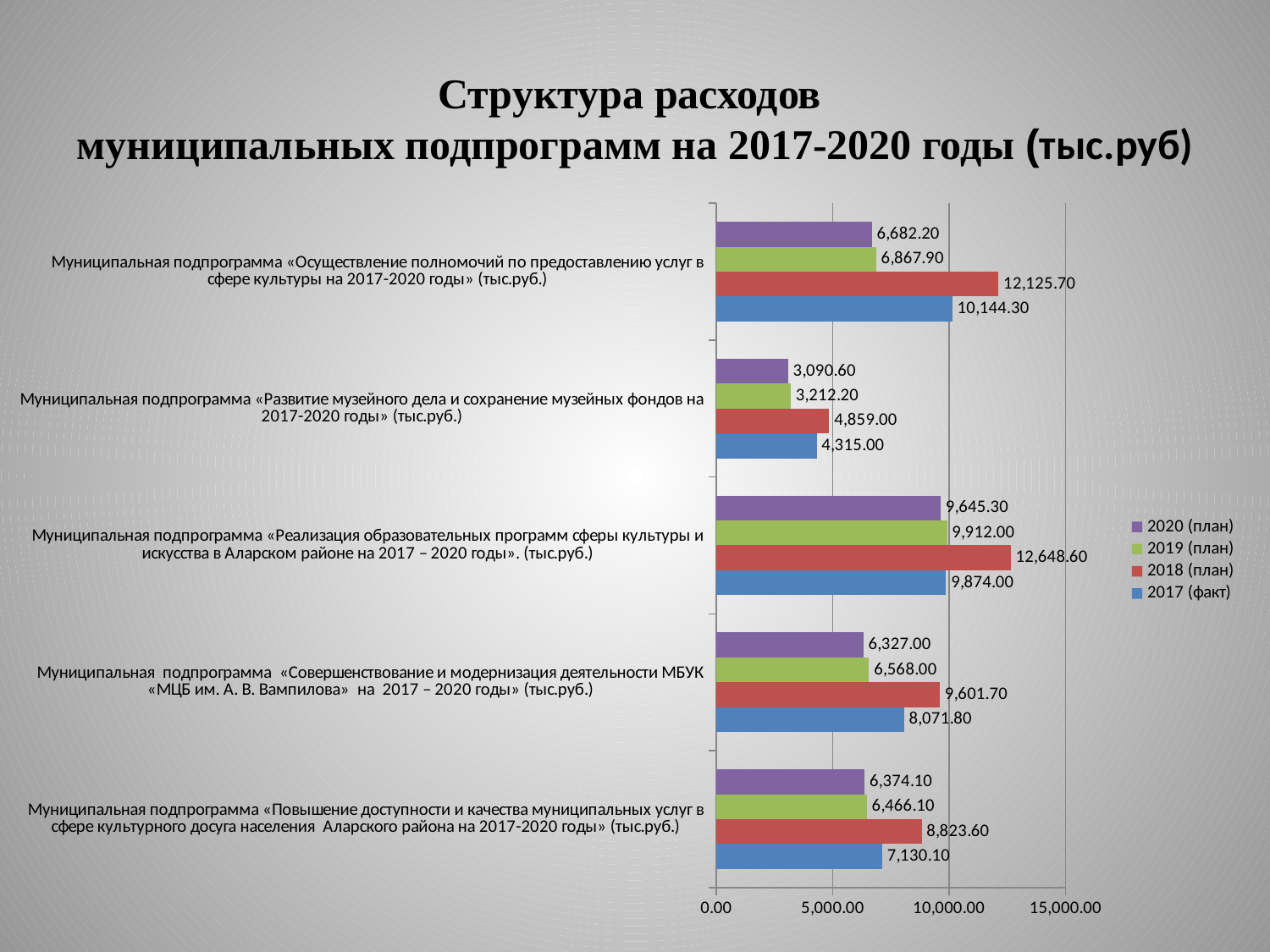
What type of chart is shown on the slide? Bar chart What is the 2020 (план) value for the subprogramme «Повышение доступности и качества муниципальных услуг в сфере культурного досуга населения Аларского района на 2017-2020 годы»? 6,374.10 What is the 2018 (план) value for the subprogramme «Осуществление полномочий по предоставлению услуг в сфере культуры на 2017-2020 годы»? 12,125.70 Which subprogramme has the lowest 2019 (план) value? «Развитие музейного дела и сохранение музейных фондов на 2017-2020 годы» How many municipal subprogrammes (categories) are plotted on the chart? 5 Which subprogramme has the highest 2018 (план) value? «Реализация образовательных программ сферы культуры и искусства в Аларском районе на 2017 – 2020 годы» Which legend entry is marked as actual (факт) rather than planned? 2017 (факт) Is the 2018 (план) value for the subprogramme «Повышение доступности и качества муниципальных услуг в сфере культурного досуга населения» greater or less than 10,000.00? less For the subprogramme «Реализация образовательных программ сферы культуры и искусства в Аларском районе», which is larger: the 2019 (план) value or the 2017 (факт) value? 2019 (план) What is the 2017 (факт) value for the subprogramme «Развитие музейного дела и сохранение музейных фондов на 2017-2020 годы»? 4,315.00 What is the difference between the 2018 (план) and 2017 (факт) values for the subprogramme «Совершенствование и модернизация деятельности МБУК «МЦБ им. А. В. Вампилова»»? 1,529.90 How many series does the legend list? 4